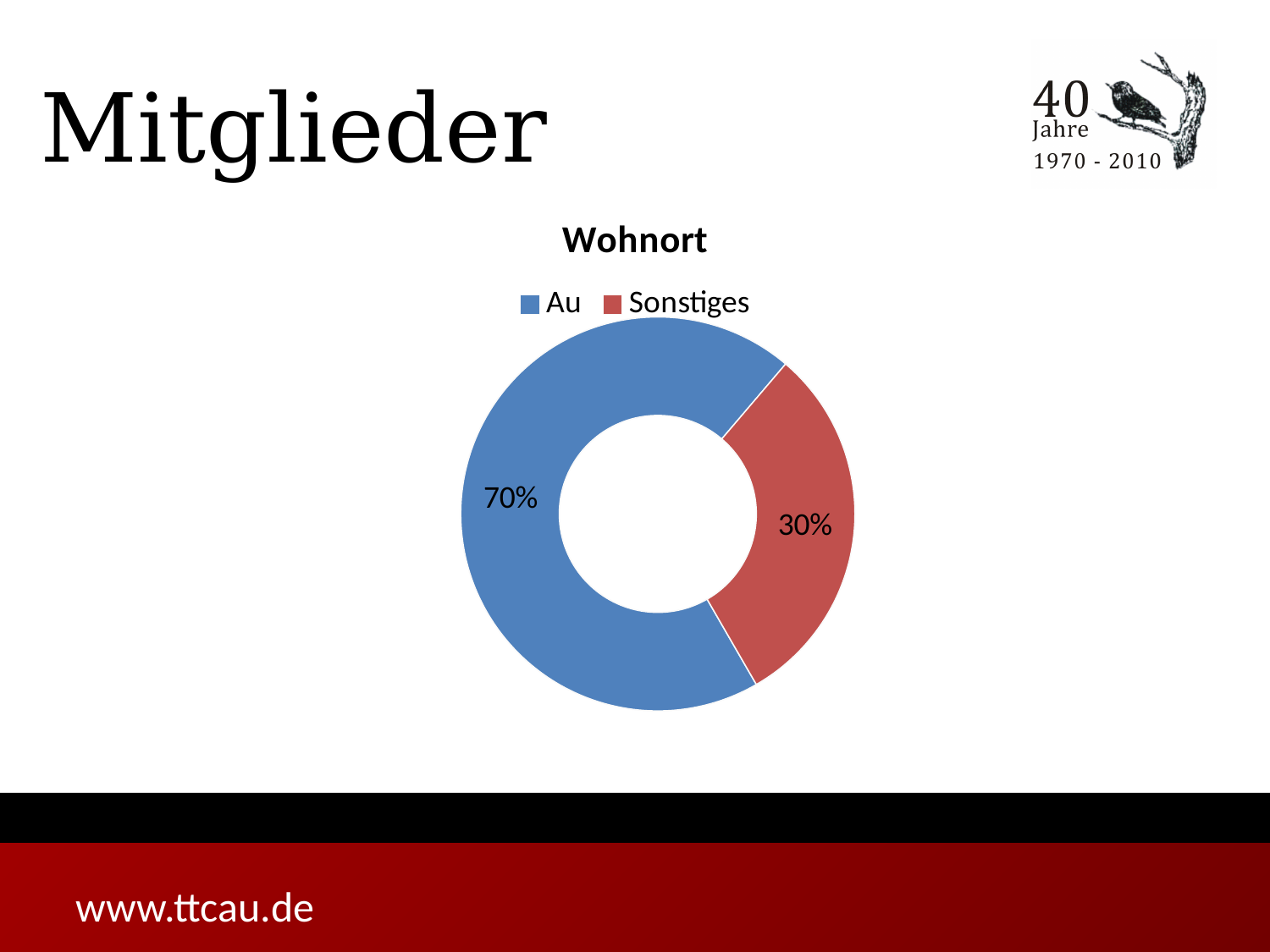
What is the difference in percentage points between the Au share and the Sonstiges share? 40 percentage points What is the title of the chart? Wohnort What kind of chart is shown on the slide? Doughnut chart What share of the chart does the Au slice take up? 70% Which category has the largest share in the chart? Au What percentage of the chart is labelled for Au? 70% What colour represents Sonstiges in the chart? Red What percentage of the chart is labelled for Sonstiges? 30% How many categories are shown in the chart? 2 Which category has the smallest share in the chart? Sonstiges How many entries does the legend list? 2 Which is larger, the share for Au or the share for Sonstiges? Au